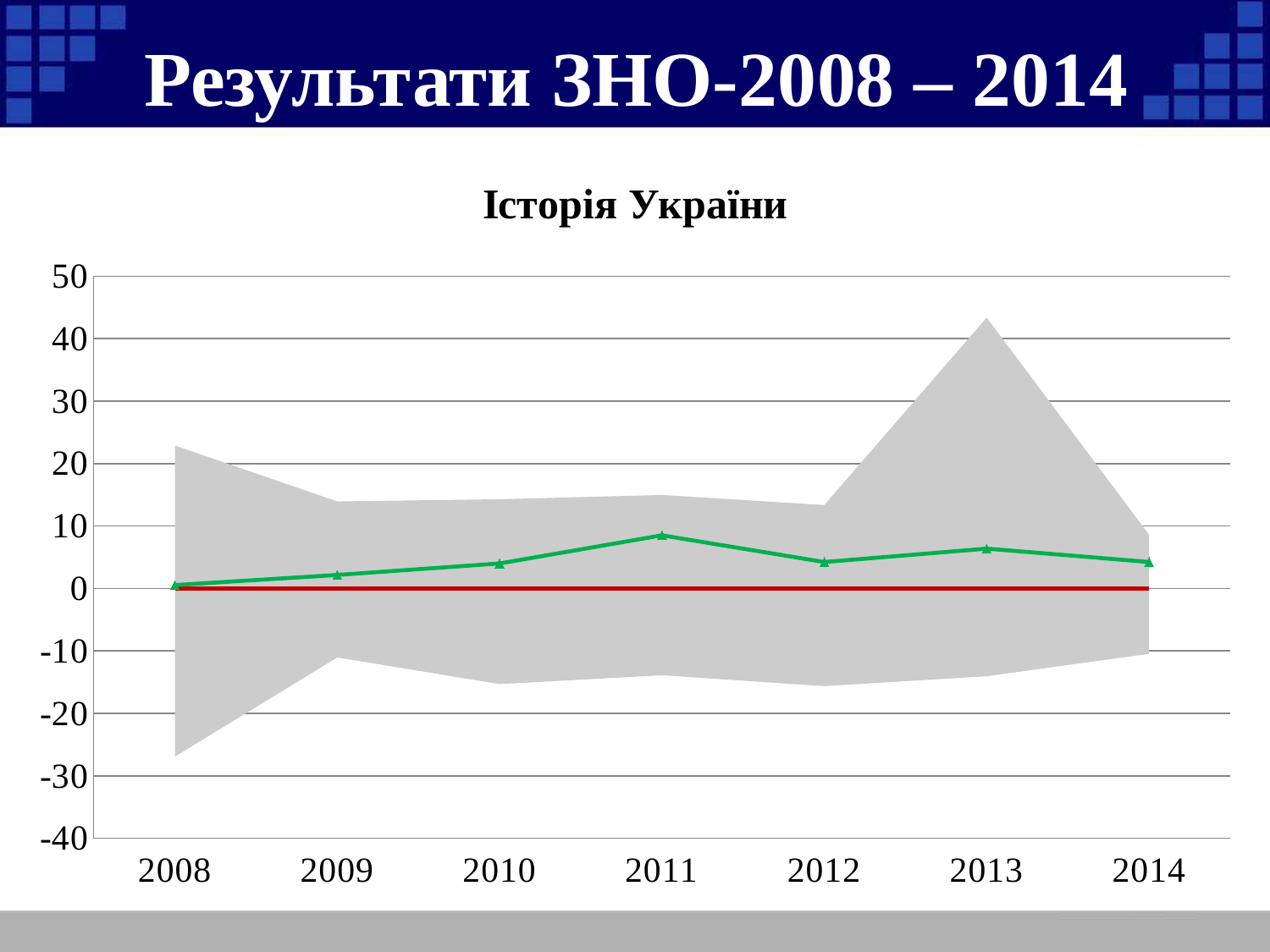
Is the upper edge of the grey shaded area in 2013 greater or less than 30? greater How many years are shown on the x axis of the chart? 7 What is the first year shown on the x axis? 2008 Is the value of the green line in 2013 greater or less than 0? greater In which year does the green line have its lowest value? 2008 Which is larger, the green line value in 2011 or in 2012? 2011 Which is larger, the green line value in 2010 or in 2009? 2010 In which year does the green line reach its highest value? 2011 What is the title of the chart? Історія України Does the green line rise or fall from 2008 to 2011? rise Is the value of the green line in 2011 greater or less than 10? less What kind of chart is shown on the slide? combination area and line chart